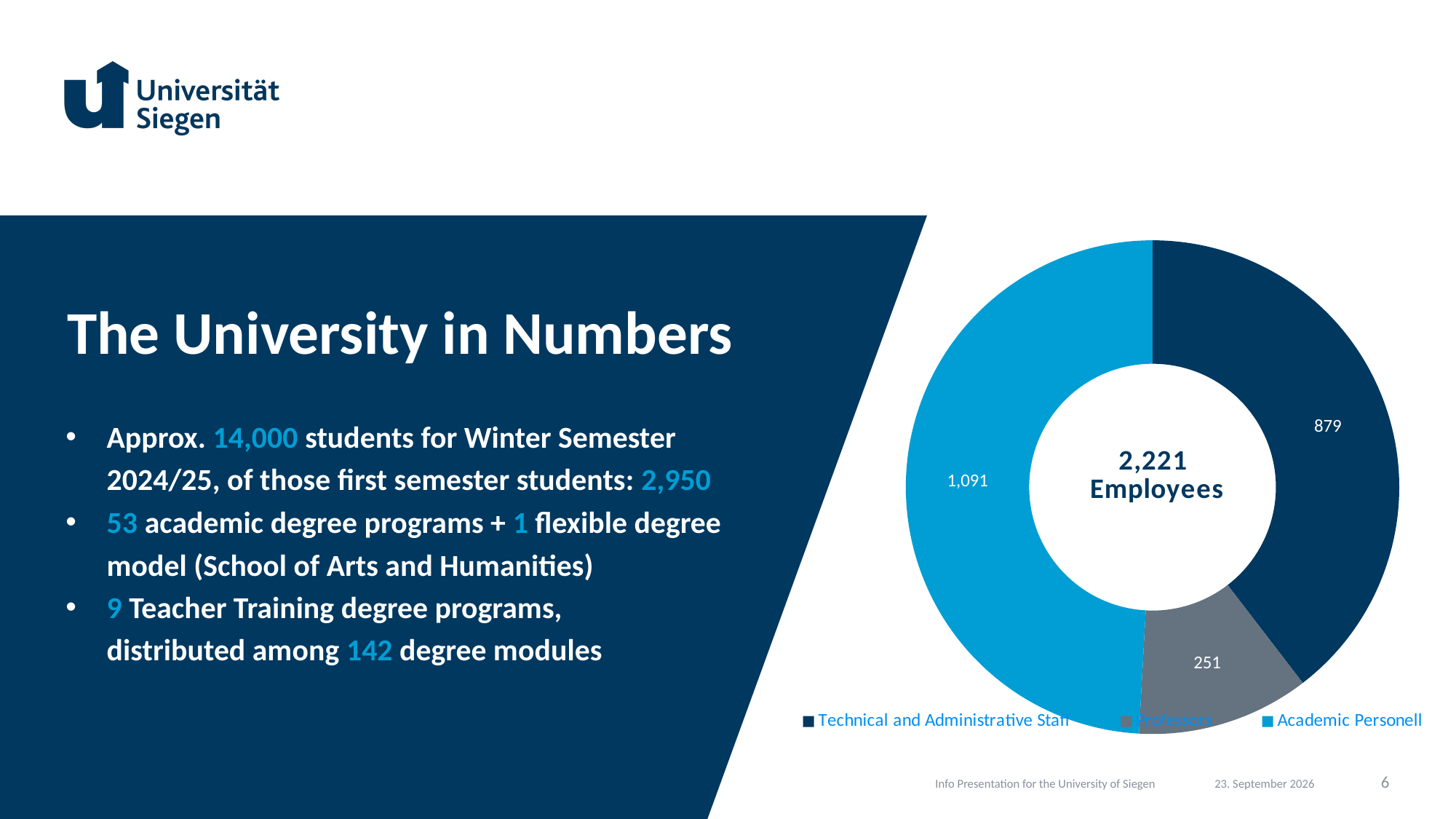
What is the value shown for Professors? 251 How many employees are Academic Personell according to the chart? 1,091 Which category has the smallest slice in the chart? Professors What is the difference between the number of Academic Personell and the number of Technical and Administrative Staff? 212 How many categories does the chart show? 3 What colour is the slice for Professors? grey What kind of chart is shown on the slide? donut chart Which is larger, the value for Professors or the value for Technical and Administrative Staff? Technical and Administrative Staff What is the difference between the number of Technical and Administrative Staff and the number of Professors? 628 Which category has the largest slice in the chart? Academic Personell What total number of employees is shown in the centre of the chart? 2,221 What is the value shown for Technical and Administrative Staff? 879